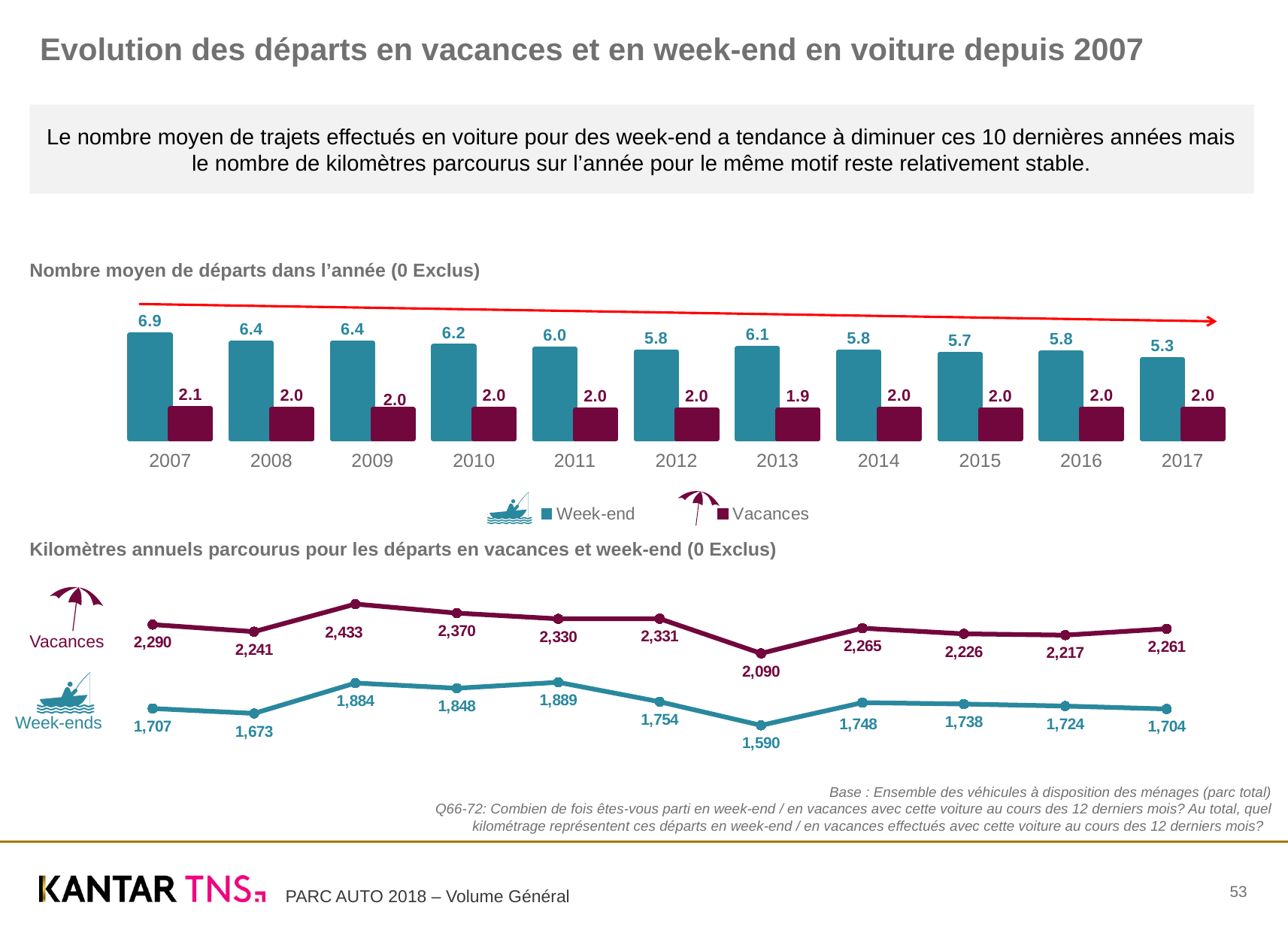
In the top chart 'Nombre moyen de départs dans l'année', which year has the lowest Week-end value? 2017 What kind of chart is the bottom chart 'Kilomètres annuels parcourus'? Line chart In the bottom chart 'Kilomètres annuels parcourus', what is the difference between the Vacances and Week-ends values for 2017? 557 In the bottom chart 'Kilomètres annuels parcourus', what is the Week-ends value for 2013? 1,590 In the bottom chart 'Kilomètres annuels parcourus', which year has the highest Week-ends value? 2011 In the top chart 'Nombre moyen de départs dans l'année', what is the Vacances value for 2013? 1.9 In the top chart 'Nombre moyen de départs dans l'année', what is the Week-end value for 2007? 6.9 What kind of chart is the top chart 'Nombre moyen de départs dans l'année'? Bar chart In the top chart 'Nombre moyen de départs dans l'année', how many series does the legend list? 2 In the bottom chart 'Kilomètres annuels parcourus', how many years are plotted? 11 In the top chart 'Nombre moyen de départs dans l'année', what is the difference between the Week-end values for 2007 and 2017? 1.6 In the bottom chart 'Kilomètres annuels parcourus', what is the Vacances value for 2009? 2,433